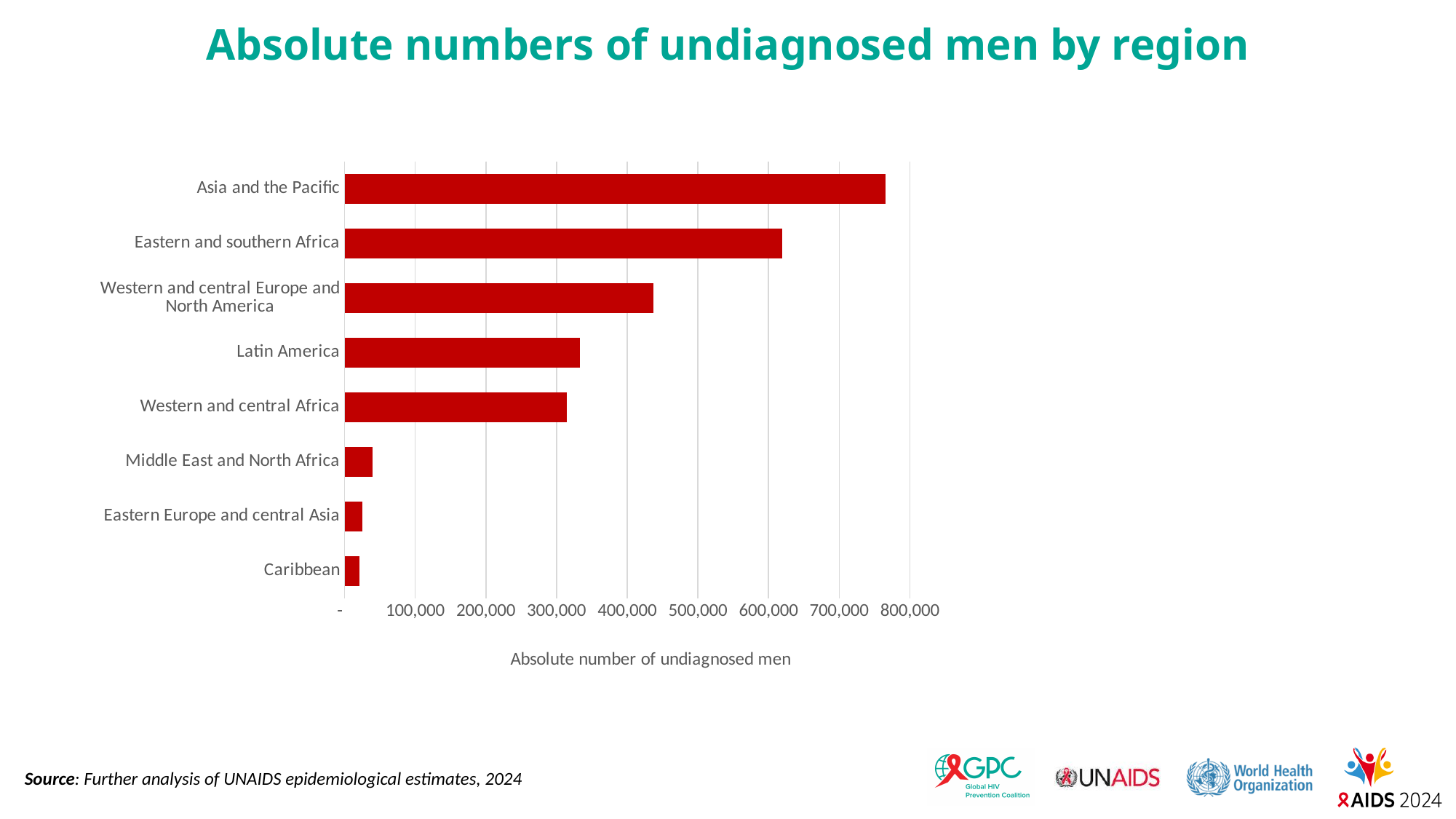
What is the label on the horizontal axis of the chart? Absolute number of undiagnosed men Is the value for Latin America greater or less than 400,000? less What kind of chart is shown on the slide? bar chart Is the value for Middle East and North Africa greater or less than 100,000? less Is the value for Eastern and southern Africa greater or less than 500,000? greater Which region has the highest absolute number of undiagnosed men? Asia and the Pacific How many regions are shown in the chart? 8 What is the title of the chart? Absolute numbers of undiagnosed men by region Which has a larger absolute number of undiagnosed men, Asia and the Pacific or Eastern and southern Africa? Asia and the Pacific Which has a larger absolute number of undiagnosed men, Western and central Europe and North America or Middle East and North Africa? Western and central Europe and North America